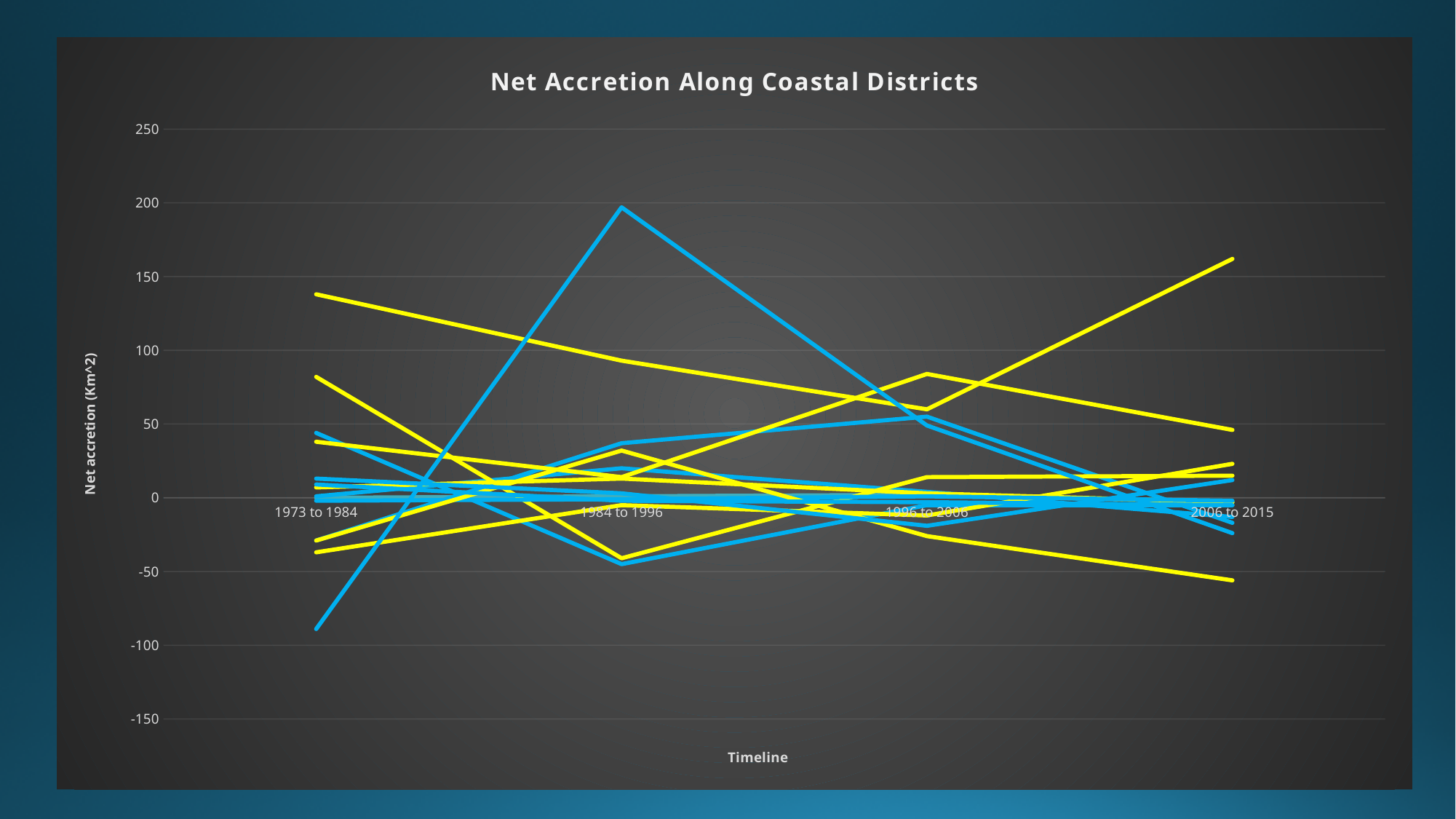
How many time periods are shown along the x axis? 4 What is the title of the chart? Net Accretion Along Coastal Districts Is the highest value plotted in the 1996 to 2006 period greater or less than 100? less What kind of chart is shown on the slide? line chart Is the highest value plotted in the 2006 to 2015 period greater or less than 150? greater Which is larger: the highest value in the 1984 to 1996 period or the highest value in the 1973 to 1984 period? 1984 to 1996 What is the maximum value shown on the y axis? 250 What is the label of the y axis? Net accretion (Km^2) In which time period does the lowest point on the chart occur? 1973 to 1984 Is the highest value plotted in the 1984 to 1996 period greater or less than 150? greater In which time period does the highest point on the chart occur? 1984 to 1996